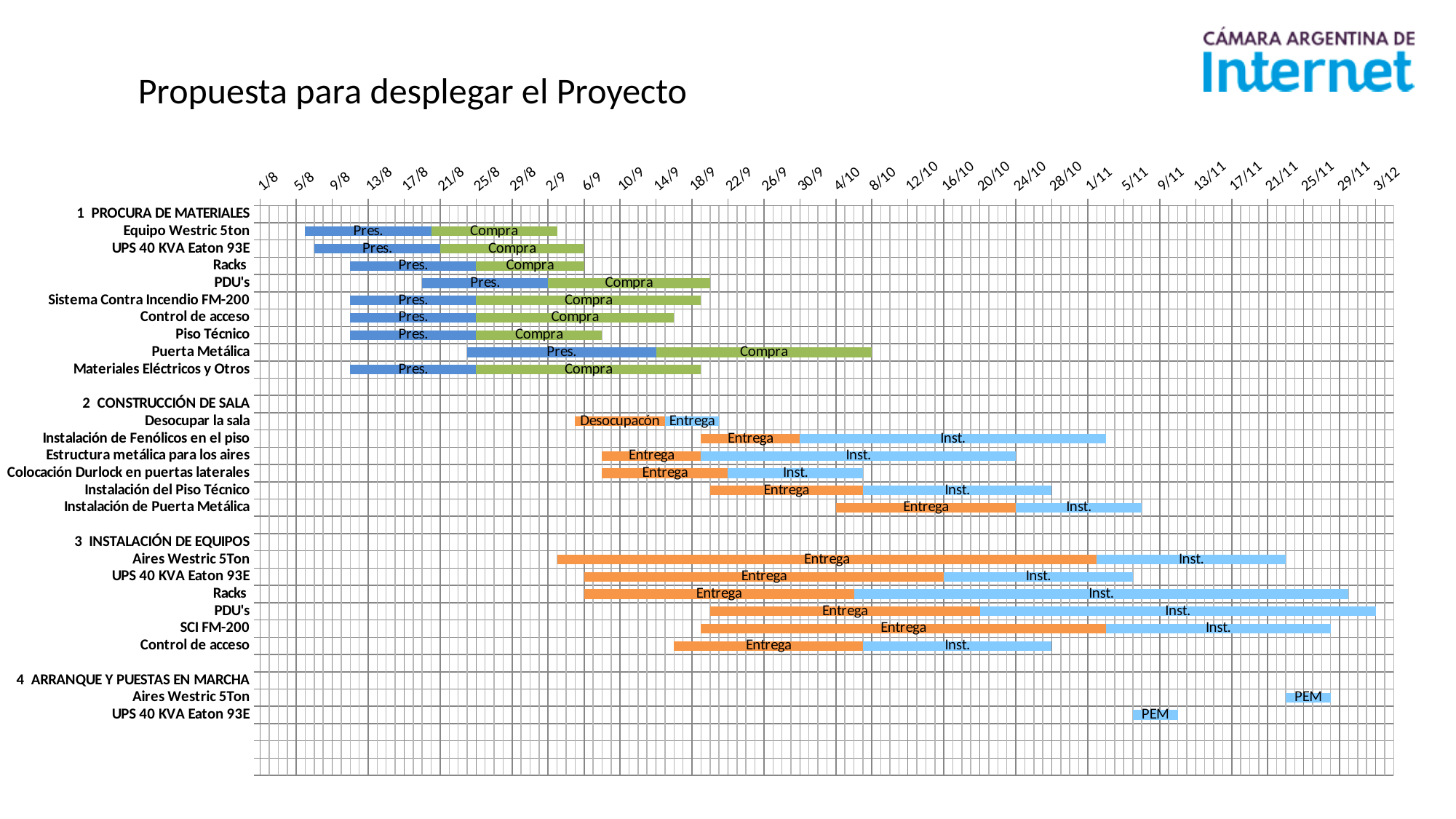
Which task in section 1 PROCURA DE MATERIALES starts earliest on the timeline? Equipo Westric 5ton How many numbered sections (phases) does the chart list? 4 Which task in section 1 PROCURA DE MATERIALES starts latest on the timeline? Puerta Metálica In section 4, which PEM bar occurs earlier: Aires Westric 5Ton or UPS 40 KVA Eaton 93E? UPS 40 KVA Eaton 93E What are the first and last dates shown on the timeline axis? 1/8 and 3/12 Which task in section 3 INSTALACIÓN DE EQUIPOS starts earliest on the timeline? Aires Westric 5Ton How many tasks are listed under section 2 CONSTRUCCIÓN DE SALA? 6 What kind of chart is shown on the slide? Gantt chart Which task in section 1 PROCURA DE MATERIALES has the longest Compra bar? Sistema Contra Incendio FM-200 and Materiales Eléctricos y Otros (tied) What is the title of the slide containing the chart? Propuesta para desplegar el Proyecto How many tasks are listed under section 4 ARRANQUE Y PUESTAS EN MARCHA? 2